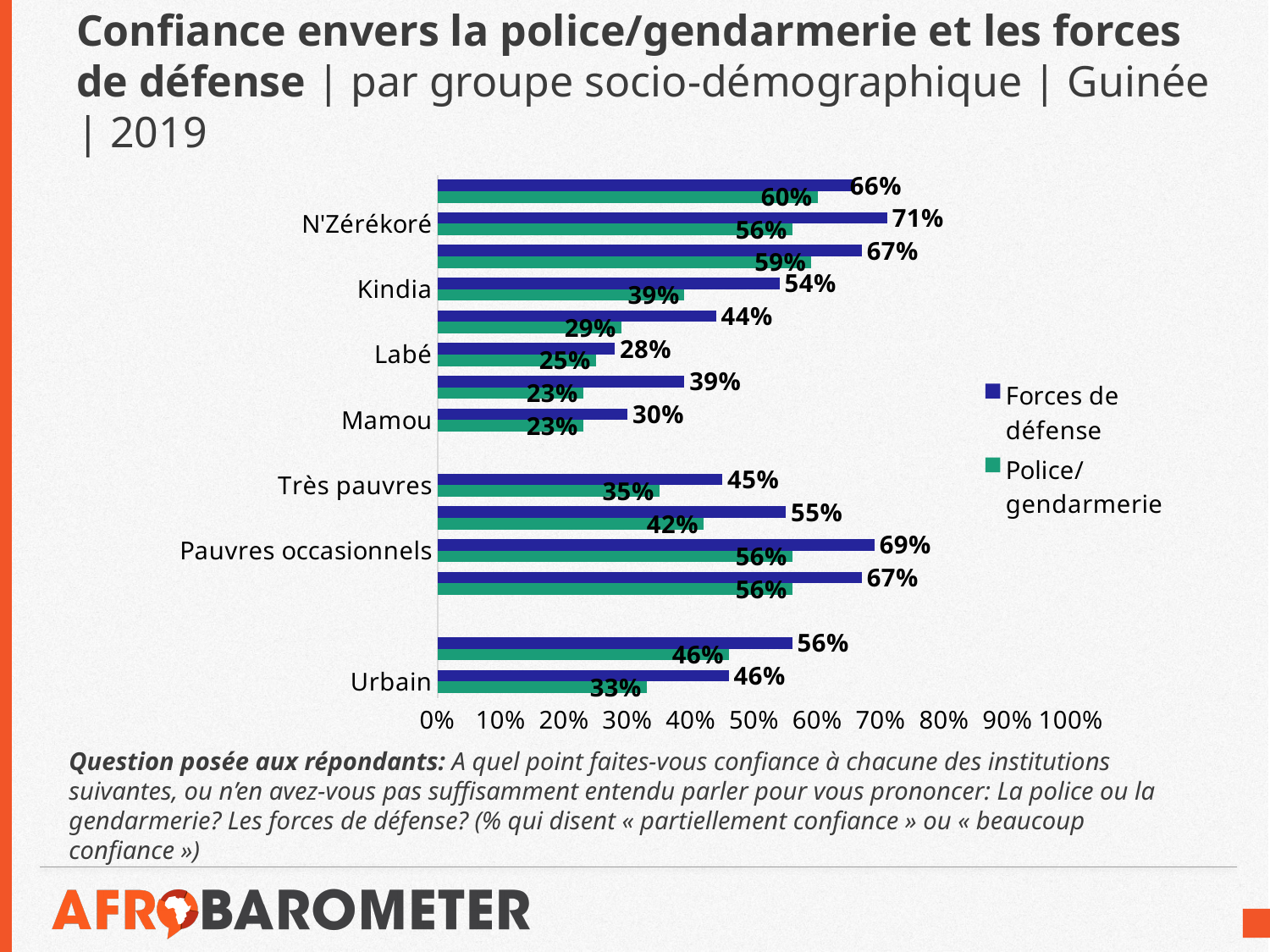
What is the value for Police/gendarmerie for Urbain? 33% Which labelled category has the lowest value for Forces de défense? Labé What is the difference between Forces de défense and Police/gendarmerie for Kindia? 15 percentage points What is the value for Police/gendarmerie for Kindia? 39% How many series does the legend list? 2 What is the value for Forces de défense for N'Zérékoré? 71% What is the value for Forces de défense for Pauvres occasionnels? 69% Which is larger for Très pauvres: Forces de défense or Police/gendarmerie? Forces de défense Which colour represents Police/gendarmerie in the legend? Green What is the value for Forces de défense for Mamou? 30% What kind of chart is shown on the slide? Bar chart Which labelled category has the highest value for Forces de défense? N'Zérékoré